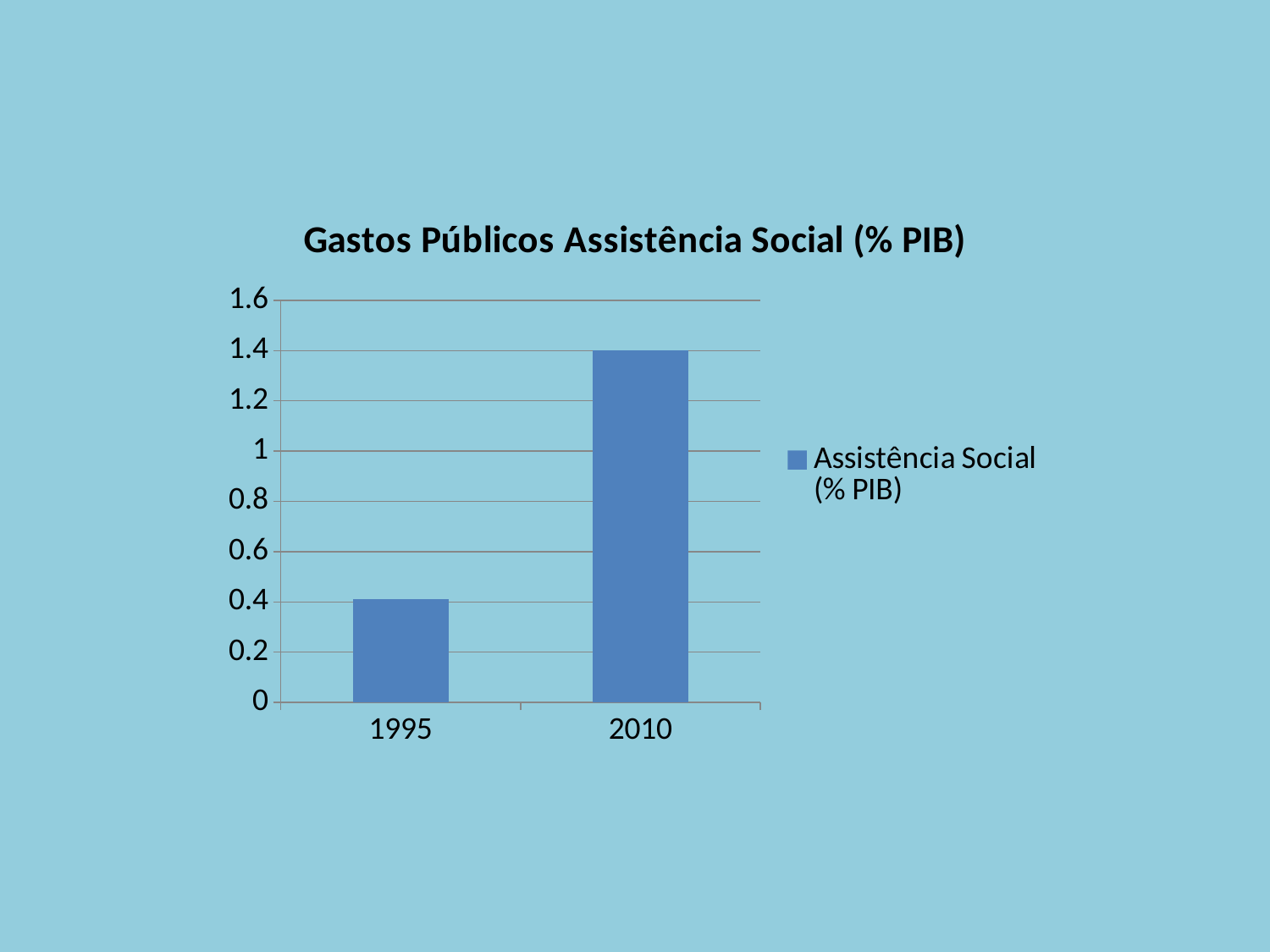
What kind of chart is shown on the slide? bar chart What is the value for 2010? 1.4 Is the value for 2010 greater or less than 1? greater How many categories are shown on the x axis? 2 How many series does the legend list? 1 Which year has the lowest value? 1995 Is the value for 1995 greater or less than 0.6? less Do the values rise or fall from 1995 to 2010? rise What is the title of the chart? Gastos Públicos Assistência Social (% PIB) Is the value for 1995 greater or less than 0.2? greater Which is larger, the value for 1995 or the value for 2010? 2010 Which year has the highest value? 2010